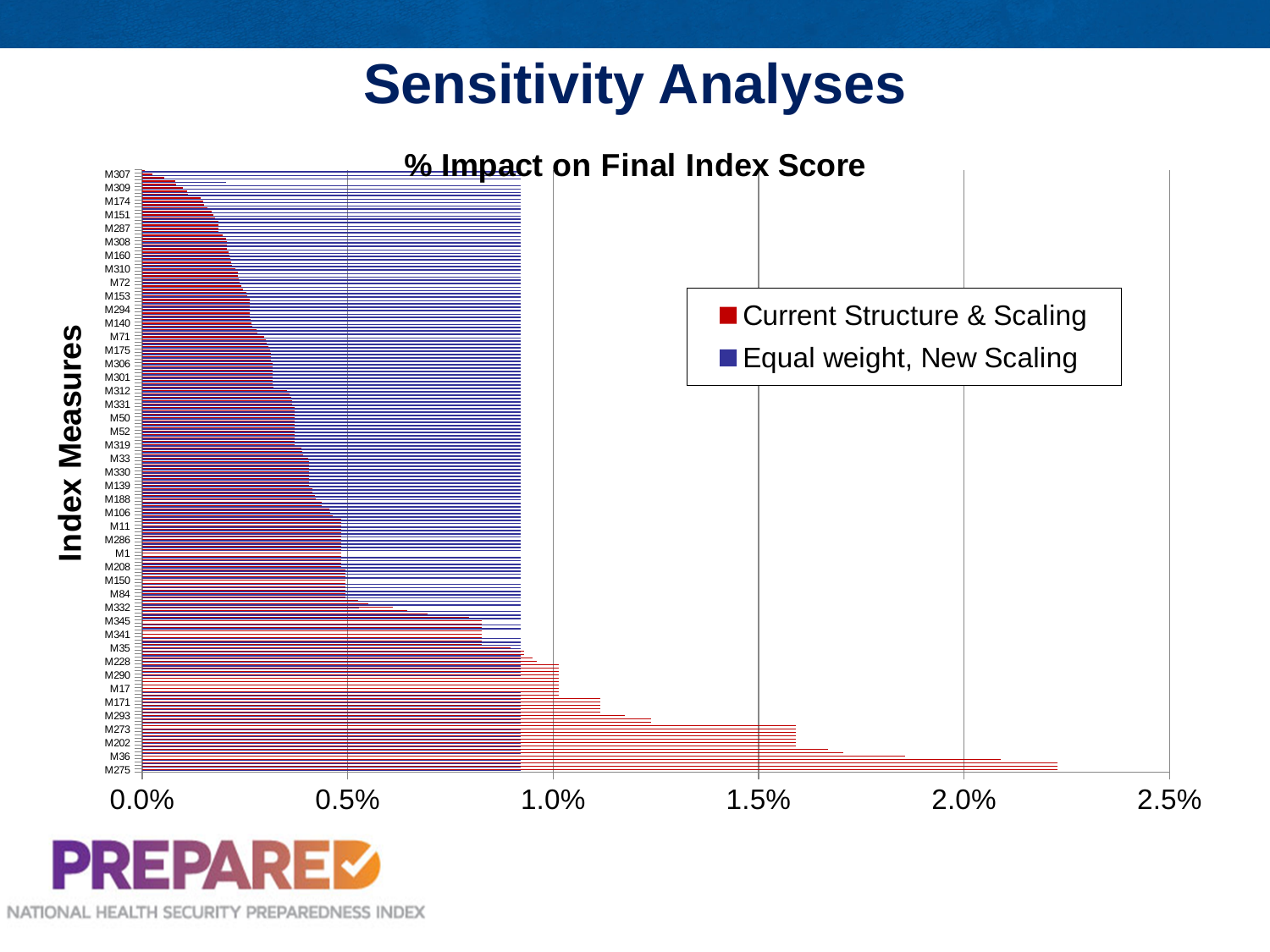
What is the label on the vertical axis of the chart? Index Measures For M275, which series has the larger value: Current Structure & Scaling or Equal weight, New Scaling? Current Structure & Scaling Is the Equal weight, New Scaling value for M275 greater or less than 1.0%? less For M307, which series has the larger value: Current Structure & Scaling or Equal weight, New Scaling? Equal weight, New Scaling Is the Current Structure & Scaling value for M275 greater or less than 1.5%? greater Do the Current Structure & Scaling values rise or fall going from M307 at the top to M275 at the bottom? rise Is the Current Structure & Scaling value for M36 greater or less than 1.5%? greater How many series does the legend list? 2 What is the title of the chart? % Impact on Final Index Score What kind of chart is shown on the slide? bar chart